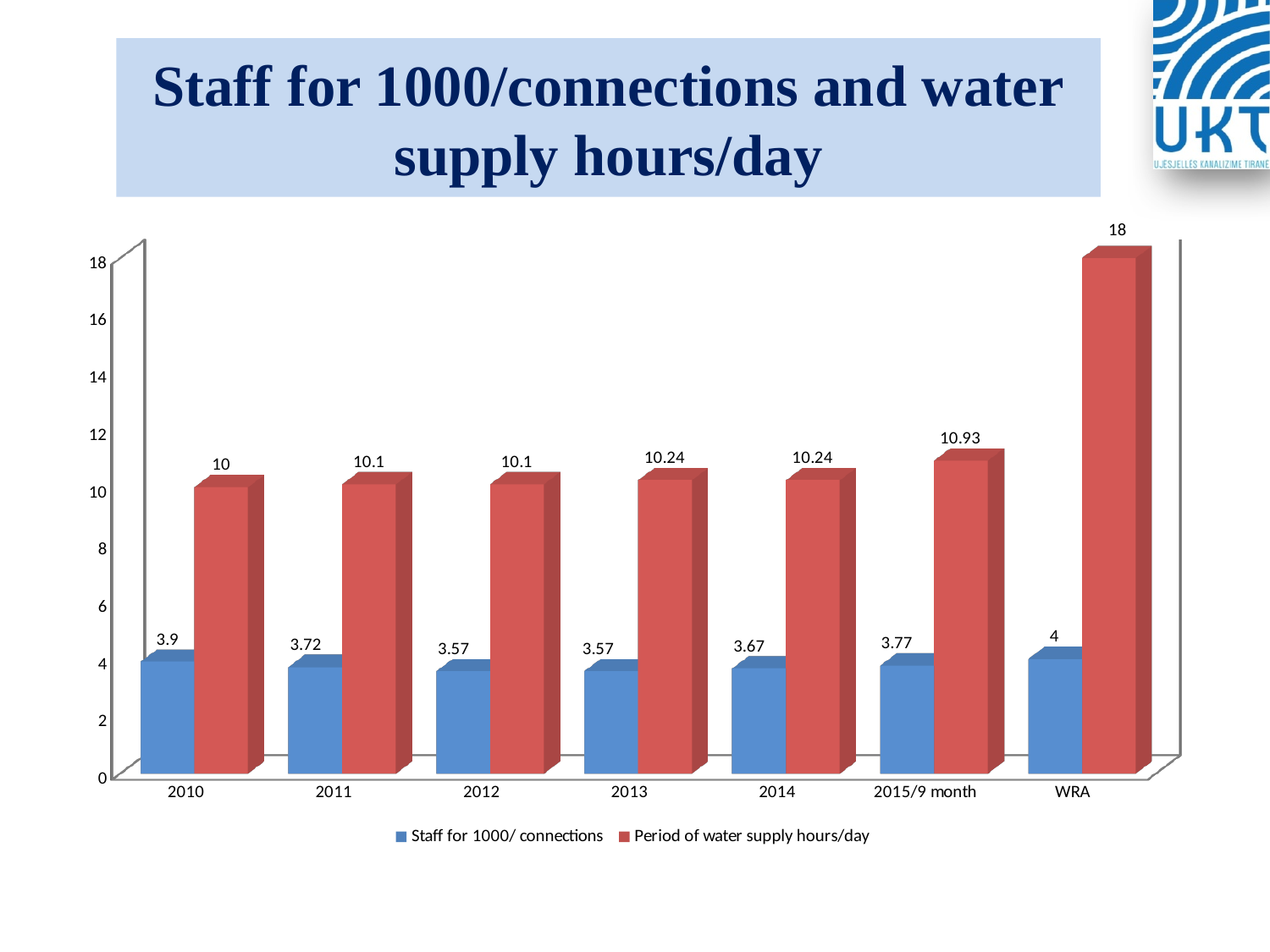
Which category has the lowest Period of water supply hours/day? 2010 Which is larger, Staff for 1000/ connections in 2010 or in 2014? 2010 What is the Period of water supply hours/day for 2015/9 month? 10.93 Which category has the highest Period of water supply hours/day? WRA Does the Period of water supply hours/day rise or fall from 2010 to WRA? rise What kind of chart is shown on the slide? bar chart What colour are the bars for Period of water supply hours/day? red How many series does the legend list? 2 What is the value of Staff for 1000/ connections in 2010? 3.9 How many categories are shown on the x axis? 7 What is the difference between the Period of water supply hours/day for WRA and for 2015/9 month? 7.07 What is the Period of water supply hours/day for WRA? 18